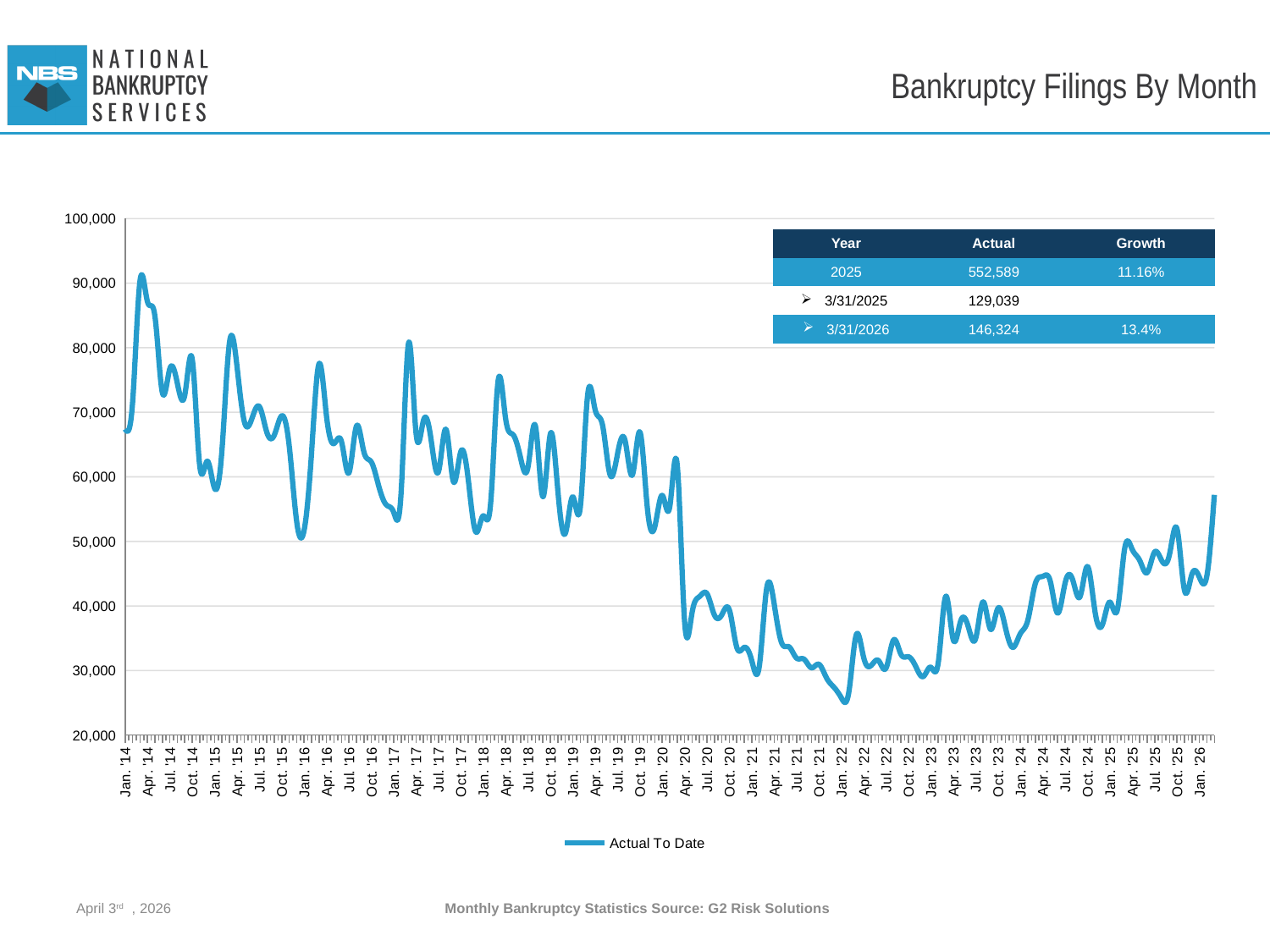
Do the values generally rise or fall from Jan. '22 to Jan. '26? rise In the table on the chart, what is the Growth value for 3/31/2026? 13.4% Is the value for Jan. '22 greater or less than 30,000? less Which is larger, the value for Apr. '14 or the value for Jan. '22? Apr. '14 What is the name of the series shown in the legend? Actual To Date Is the value for Jan. '14 greater or less than 60,000? greater Is the value for Apr. '14 greater or less than 80,000? greater In the table on the chart, what is the difference between the Actual values for 3/31/2026 and 3/31/2025? 17,285 In the table on the chart, what is the Actual value for 2025? 552,589 What is the title of the chart? Bankruptcy Filings By Month How many series does the legend list? 1 What kind of chart is shown on the slide? line chart